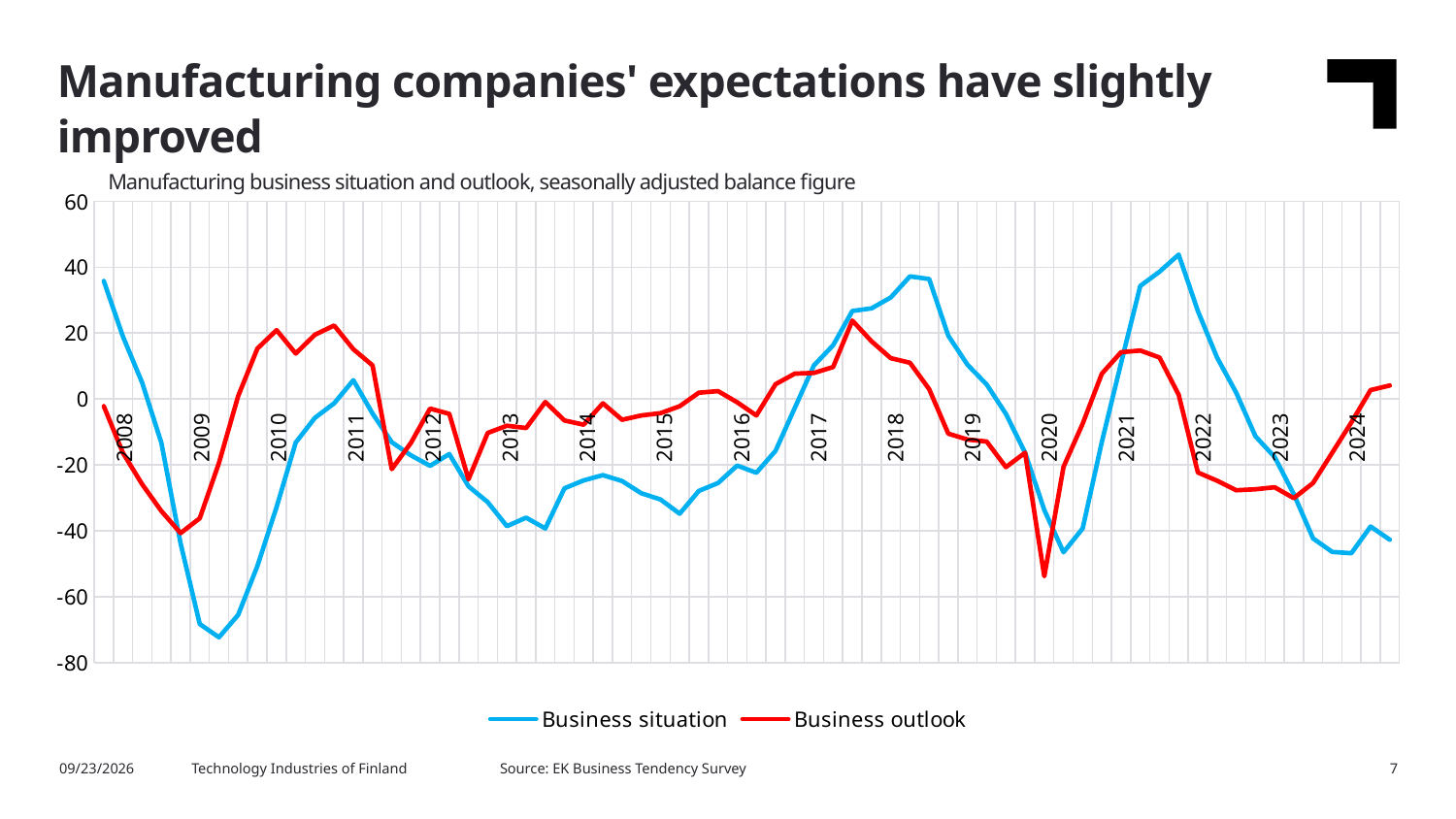
Does the Business situation line rise or fall between its 2021 peak and 2023? Fall Which series is higher at the end of the chart in 2024, Business situation or Business outlook? Business outlook Does the Business outlook line rise or fall from 2023 to 2024? Rise Is the highest value of the Business situation line, around 2021-2022, greater or less than 40? greater What are the two series named in the legend? Business situation and Business outlook Is the lowest value of the Business outlook line, around 2020, greater or less than -40? less How many year labels are shown on the x axis? 17 Is the lowest value of the Business situation line, around 2009, greater or less than -60? less What kind of chart is shown on the slide? Line chart Which series reaches the lower value around 2009, Business situation or Business outlook? Business situation What is the subtitle of the chart? Manufacturing business situation and outlook, seasonally adjusted balance figure How many series does the legend list? 2